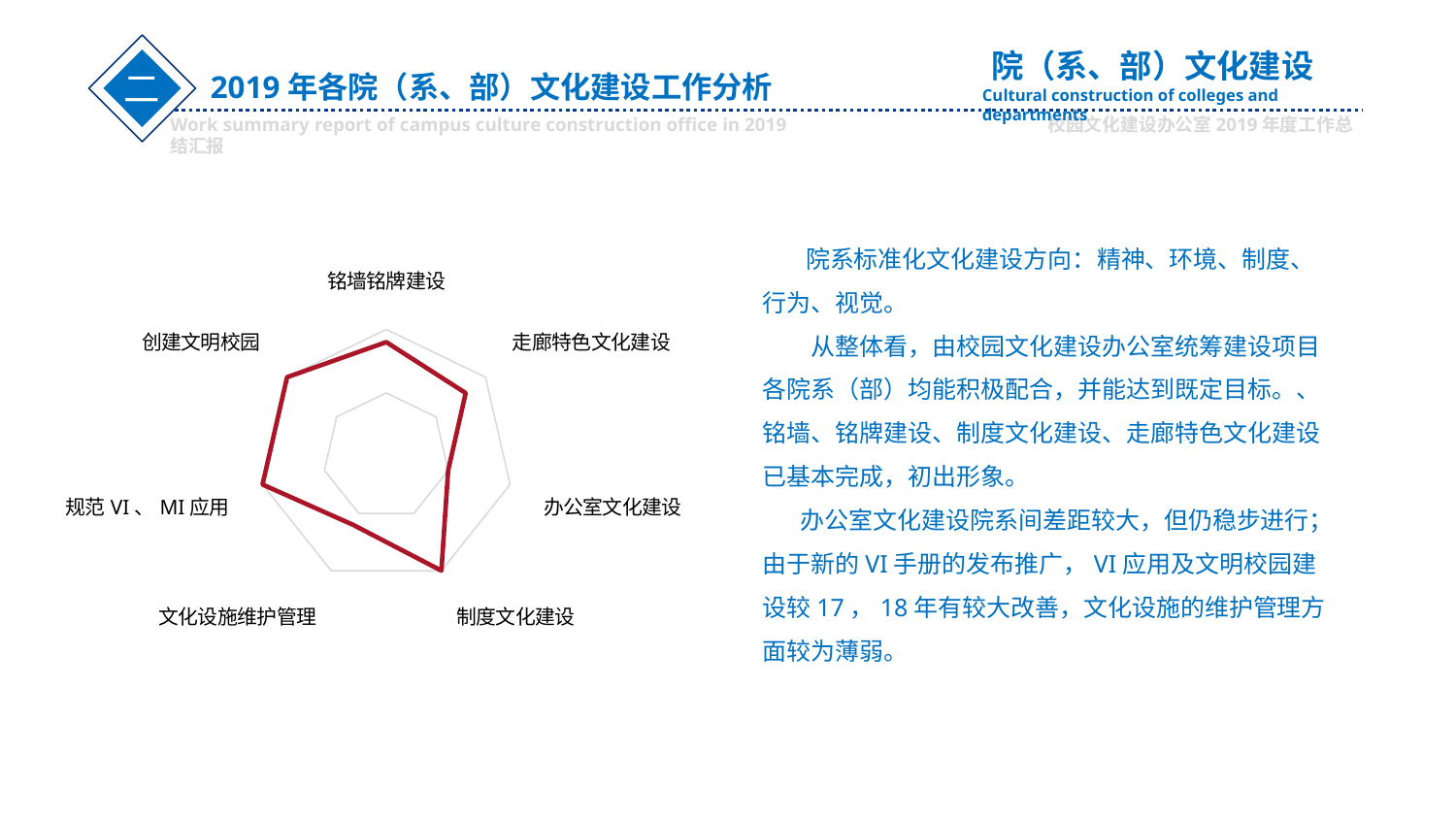
Which is larger on the radar chart, 铭墙铭牌建设 or 文化设施维护管理? 铭墙铭牌建设 What kind of chart is shown on the left of the slide? Radar chart Which category label appears at the top of the radar chart? 铭墙铭牌建设 Which is larger on the radar chart, 制度文化建设 or 办公室文化建设? 制度文化建设 How many categories (axes) does the radar chart have? 7 Which is larger on the radar chart, 规范 VI、MI 应用 or 办公室文化建设? 规范 VI、MI 应用 Which category has the lowest value on the radar chart? 办公室文化建设 What colour is the data line on the radar chart? Red